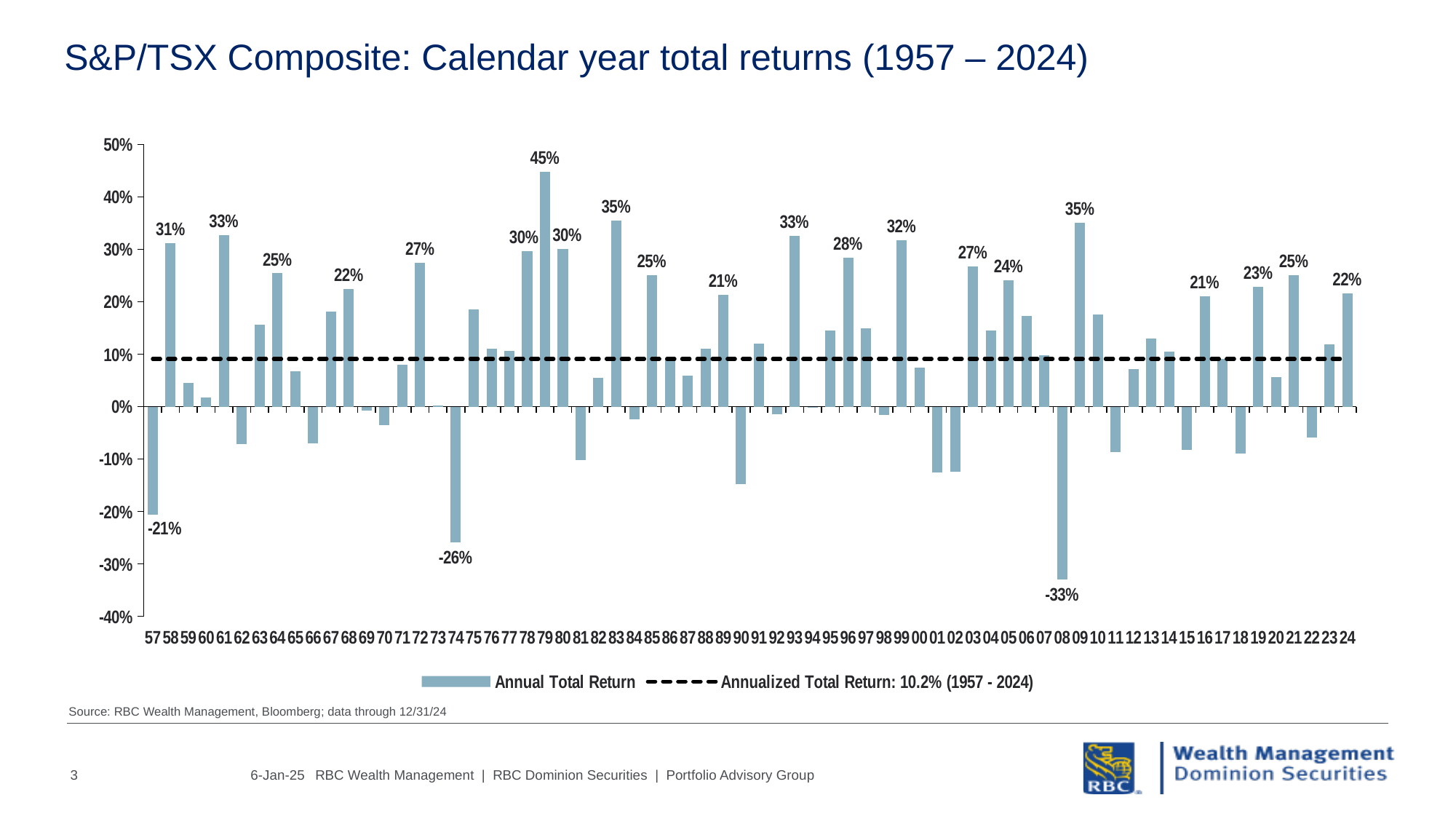
How many calendar years are plotted in the chart? 68 What was the total return in 2024? 22% What annualized total return for 1957 - 2024 does the legend state for the dashed line? 10.2% What is the difference in percentage points between the 1979 return and the 2008 return? 78 percentage points What was the total return in 2008? -33% Which year had the highest annual total return? 1979 Is the value for 2010 greater or less than 10%? greater What kind of chart is shown on the slide? Bar chart Which year had the larger total return, 1983 or 1993? 1983 Which year had the lowest annual total return? 2008 What was the S&P/TSX Composite total return in 1979? 45% Is the value for 1990 greater or less than -10%? less